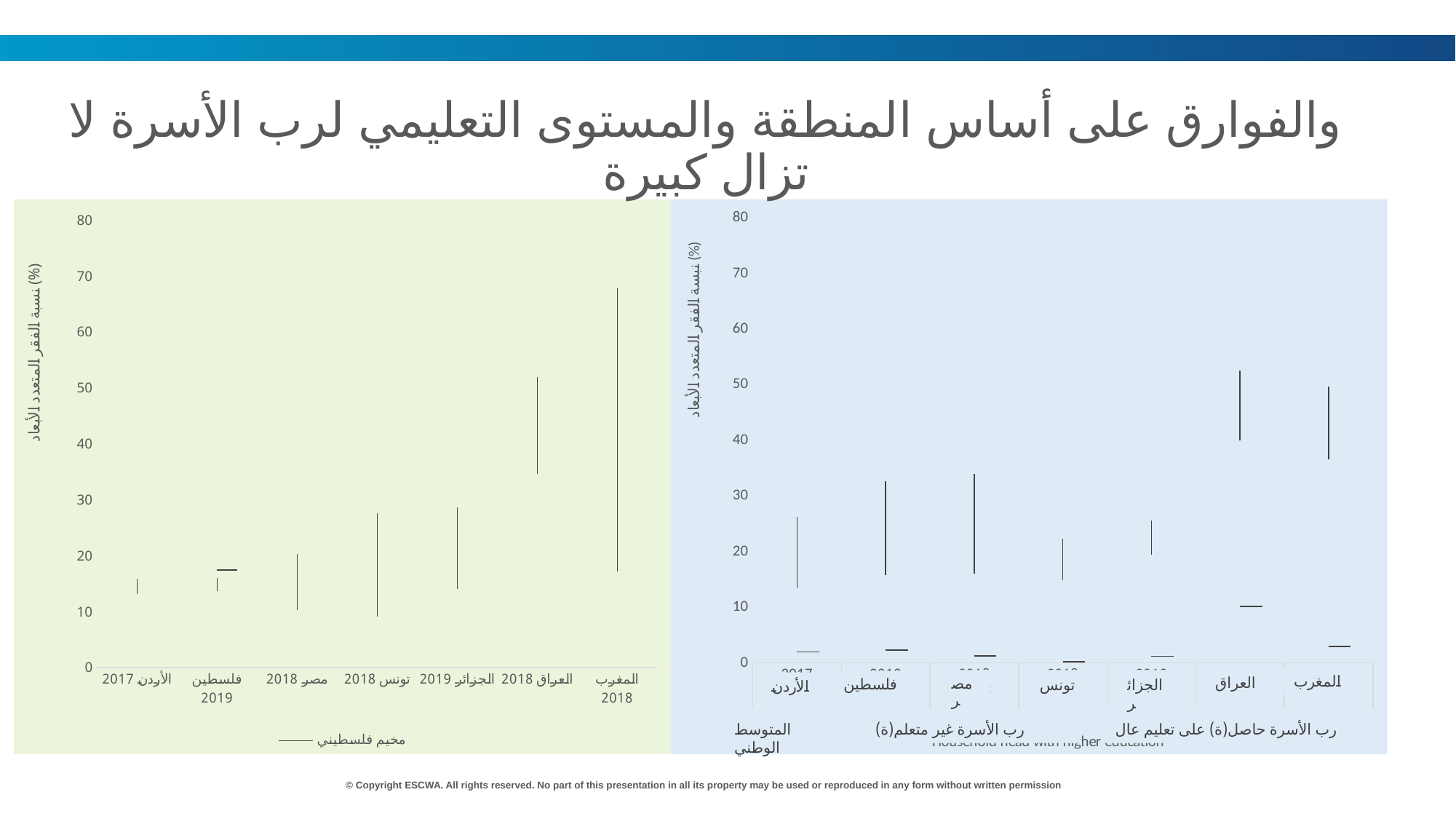
In the right chart (blue background), which reaches a higher value: مصر or تونس? مصر In the right chart (blue background), is the highest point of the range for تونس greater or less than 30? less In the left chart (green background), which category reaches the highest value? المغرب 2018 In the left chart (green background), is the highest point of the range for الأردن 2017 greater or less than 20? less How many categories are shown on the x axis of the left chart (green background)? 7 How many categories are shown on the x axis of the right chart (blue background)? 7 What is the legend entry of the left chart (green background)? مخيم فلسطيني In the left chart (green background), which reaches a higher value: المغرب 2018 or العراق 2018? المغرب 2018 How many series does the legend of the right chart (blue background) list? 3 How many series does the legend of the left chart (green background) list? 1 In the left chart (green background), is the highest point of the range for المغرب 2018 greater or less than 60? greater